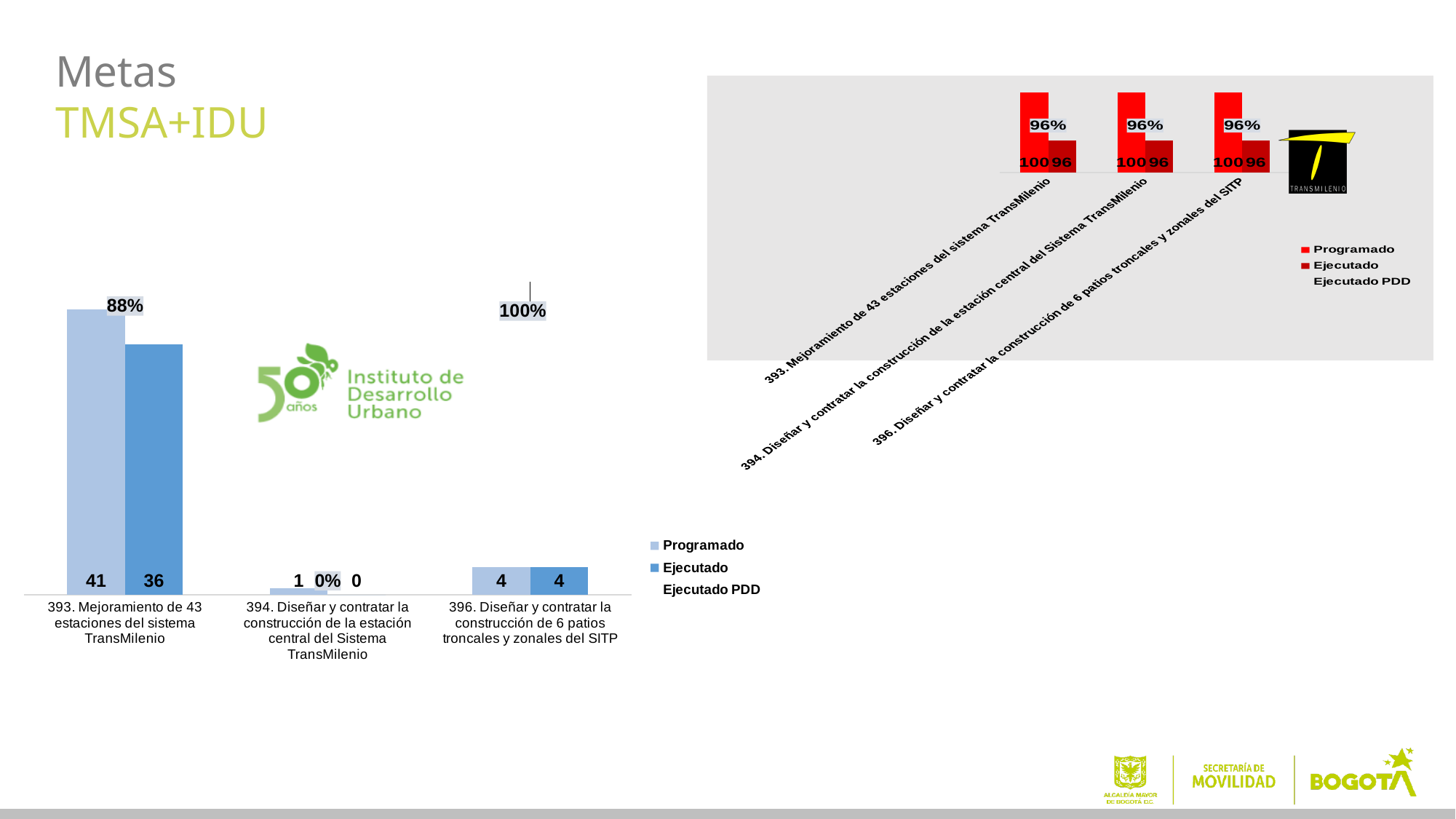
On the left chart, what is the Ejecutado PDD percentage shown for '396. Diseñar y contratar la construcción de 6 patios troncales y zonales del SITP'? 100% On the left chart, what is the difference between the Programado and Ejecutado values for '393. Mejoramiento de 43 estaciones del sistema TransMilenio'? 5 On the left chart, which category has the highest Programado value? 393. Mejoramiento de 43 estaciones del sistema TransMilenio On the left chart, how many categories are shown on the x axis? 3 On the left chart, what is the Ejecutado PDD percentage shown for '394. Diseñar y contratar la construcción de la estación central del Sistema TransMilenio'? 0% On the left chart, what is the Ejecutado value for '393. Mejoramiento de 43 estaciones del sistema TransMilenio'? 36 How many series does the legend of the right chart list? 3 On the left chart, which category has the lowest Ejecutado value? 394. Diseñar y contratar la construcción de la estación central del Sistema TransMilenio On the right chart, what is the Ejecutado value for '396. Diseñar y contratar la construcción de 6 patios troncales y zonales del SITP'? 96 On the right chart, what Ejecutado PDD percentage is shown for '393. Mejoramiento de 43 estaciones del sistema TransMilenio'? 96% On the right chart, what is the Programado value for '394. Diseñar y contratar la construcción de la estación central del Sistema TransMilenio'? 100 On the left chart, what is the Programado value for '393. Mejoramiento de 43 estaciones del sistema TransMilenio'? 41